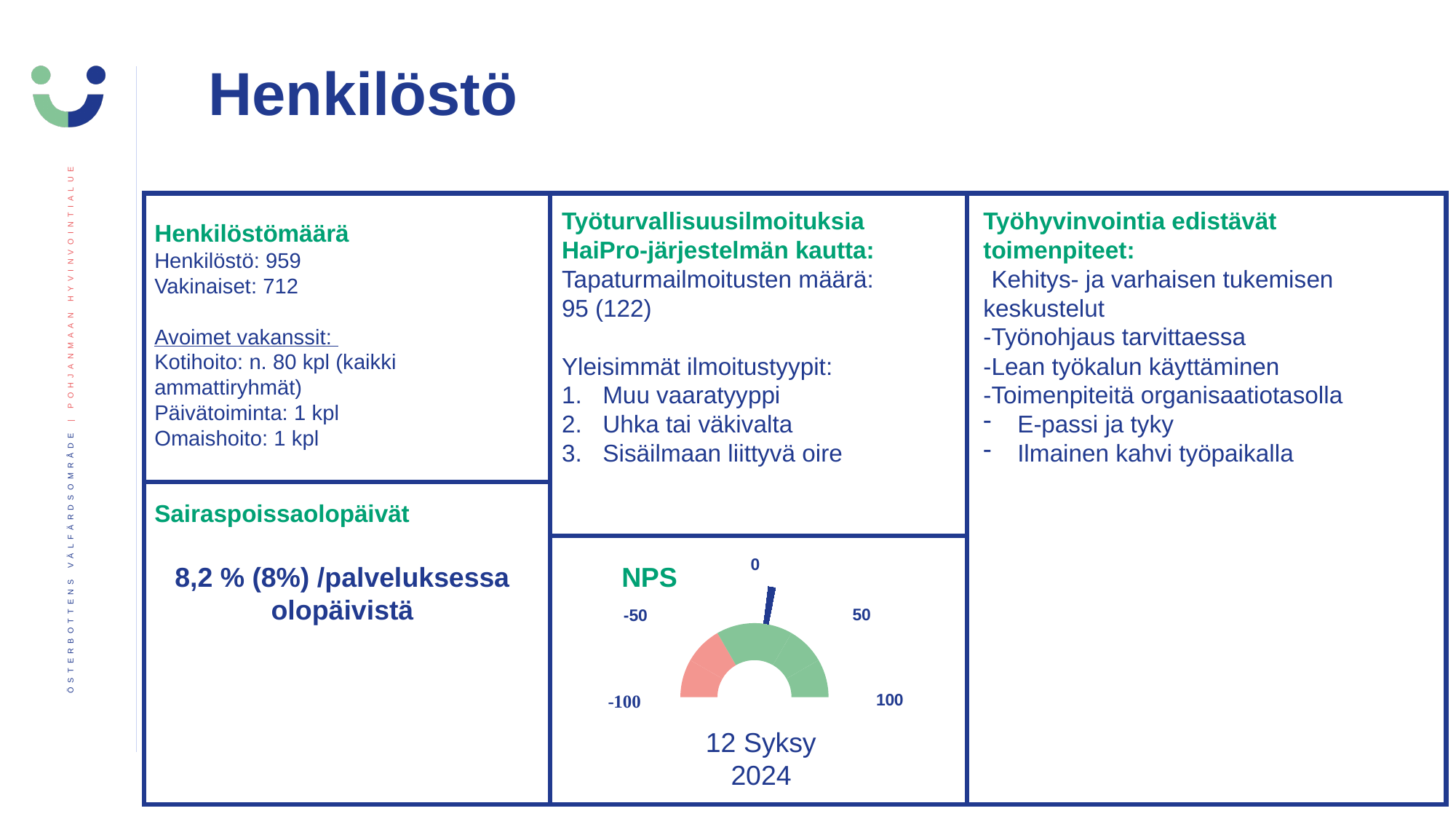
Is the NPS needle pointing to a value greater or less than 0? greater What is the lowest value labelled on the NPS gauge scale? -100 What is the title of the gauge chart on the slide? NPS What kind of chart is shown in the NPS panel? gauge chart Is the NPS needle pointing to a value greater or less than 50? less How many tick labels are printed around the NPS gauge? 5 Which colour is used for the lowest section of the NPS gauge, from -100 to about -50? red What is the highest value labelled on the NPS gauge scale? 100 Which period is the NPS gauge reading labelled for? Syksy 2024 What NPS value is shown for Syksy 2024 below the gauge? 12